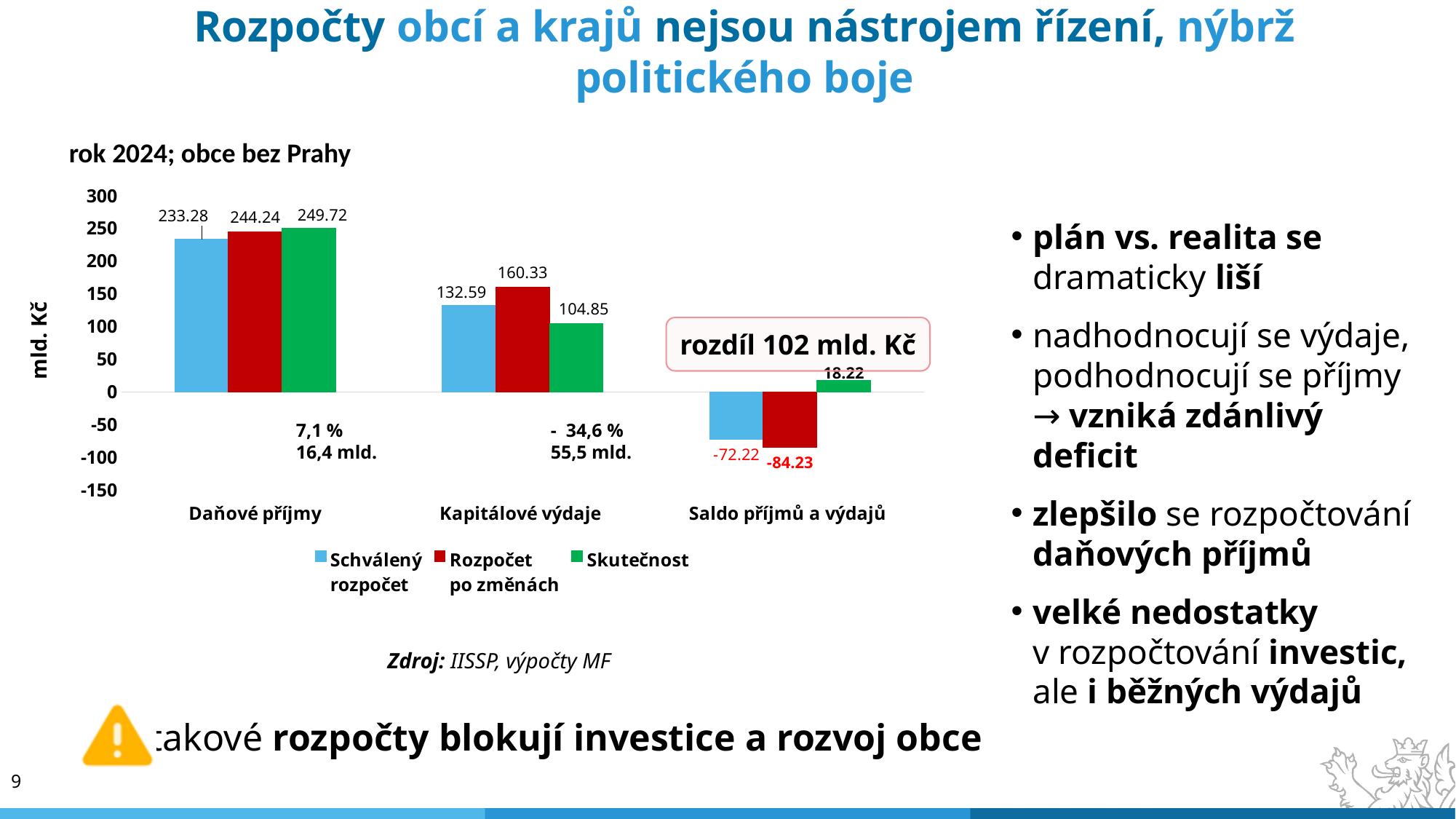
How many series does the chart legend list? 3 What is the Skutečnost value for Daňové příjmy? 249.72 What is the Schválený rozpočet value for Saldo příjmů a výdajů? -72.22 What is the Skutečnost value for Saldo příjmů a výdajů? 18.22 How many categories are shown on the x axis of the chart? 3 What is the difference between the Rozpočet po změnách and Schválený rozpočet values for Daňové příjmy? 10.96 What is the unit shown on the y axis of the chart? mld. Kč Which series has the highest value for Kapitálové výdaje? Rozpočet po změnách Which is larger for Kapitálové výdaje: Schválený rozpočet or Skutečnost? Schválený rozpočet What is the Rozpočet po změnách value for Kapitálové výdaje? 160.33 What type of chart is shown on the slide? Bar chart Which series has the lowest value for Daňové příjmy? Schválený rozpočet